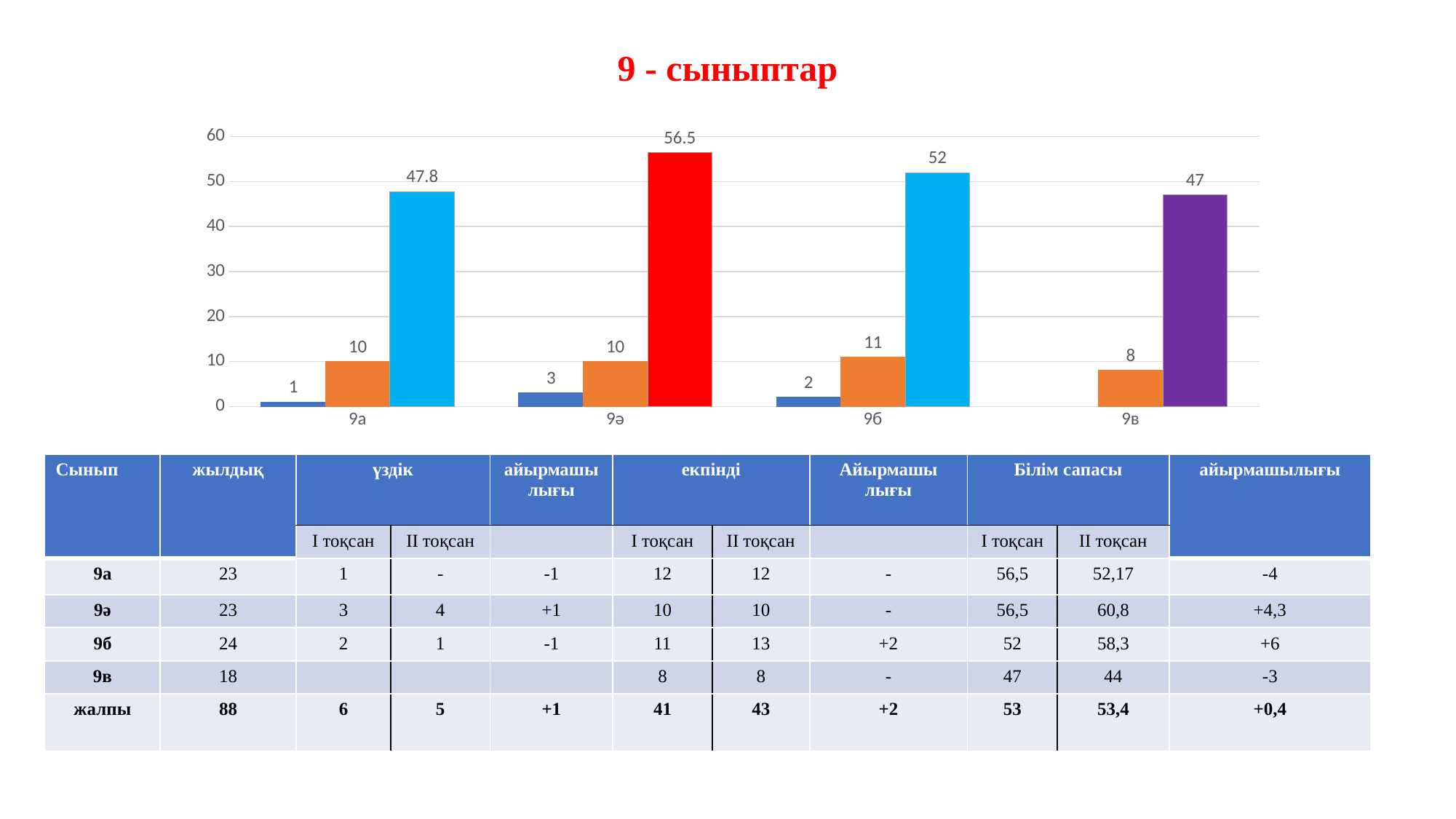
What is the value of the orange bar for category 9б? 11 Which category has the lowest value for its tallest bar? 9в What is the value of the orange bar for category 9в? 8 What is the difference between the tallest bars of 9ә and 9б? 4.5 What is the value of the tallest bar for category 9а? 47.8 Which category has the highest tallest bar? 9ә What is the value of the smallest (blue) bar for category 9ә? 3 What is the value of the tallest bar for category 9ә? 56.5 How many categories are shown on the x axis of the chart? 4 What is the title of the slide above the chart? 9 - сыныптар Which is larger: the tallest bar for 9б or the tallest bar for 9а? 9б What type of chart is shown on the slide? bar chart